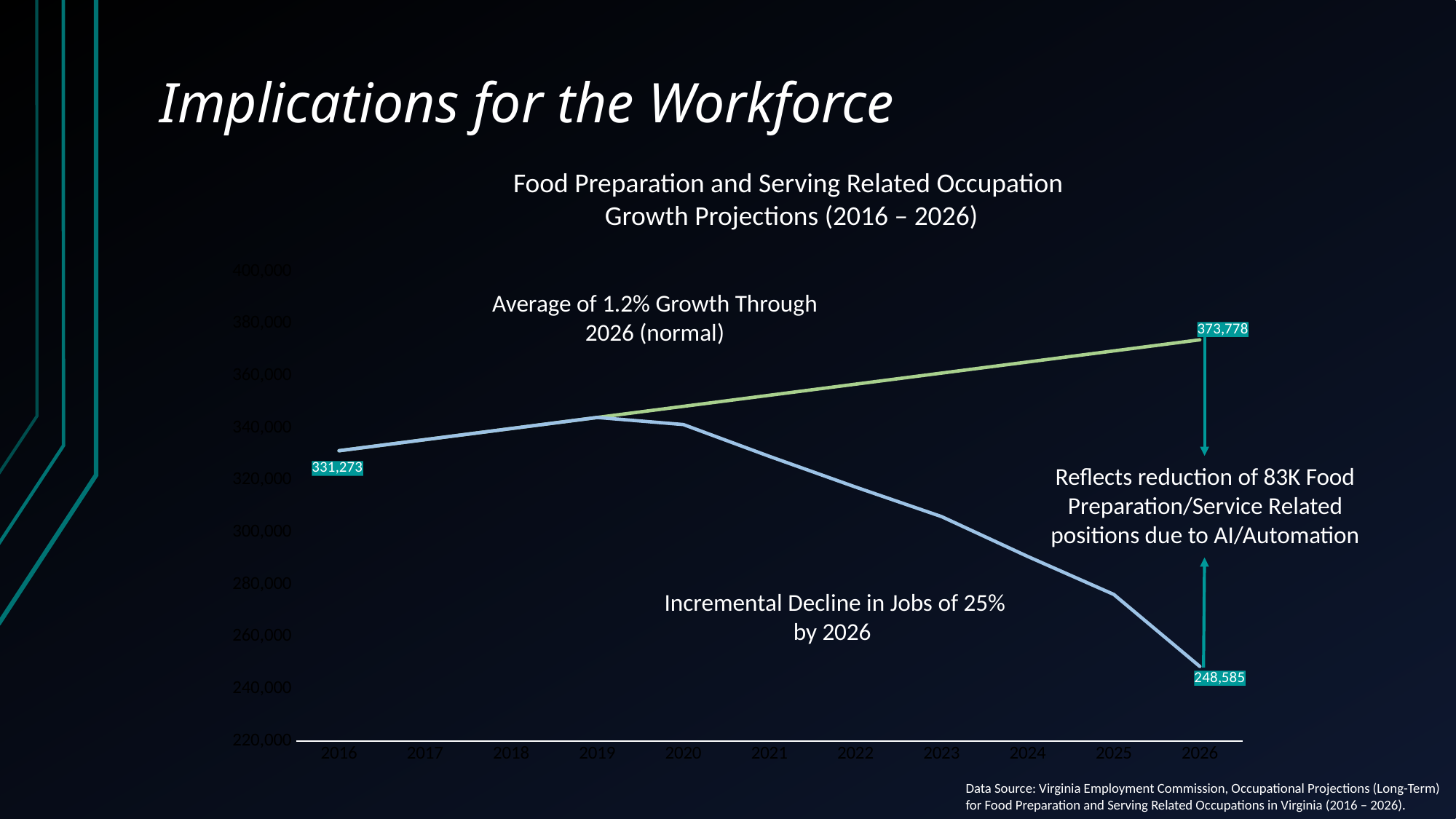
What is the value shown for 2016? 331,273 How many years are labelled on the x axis? 11 What is the 2026 value on the lower (blue) decline line? 248,585 What is the difference between the two 2026 values, 373,778 and 248,585? 125,193 Is the value on the blue line for 2025 greater or less than 280,000? less What kind of chart is shown on the slide? line chart Is the value on the blue line for 2023 greater or less than 300,000? greater How much higher is the 2026 growth-line value (373,778) than the 2016 value (331,273)? 42,505 Does the blue line rise or fall from 2020 to 2026? fall Which is larger, the 2016 value or the 2026 value on the blue decline line? 2016 value What is the title of the chart? Food Preparation and Serving Related Occupation Growth Projections (2016 – 2026) What is the 2026 value on the upper (green) growth line? 373,778